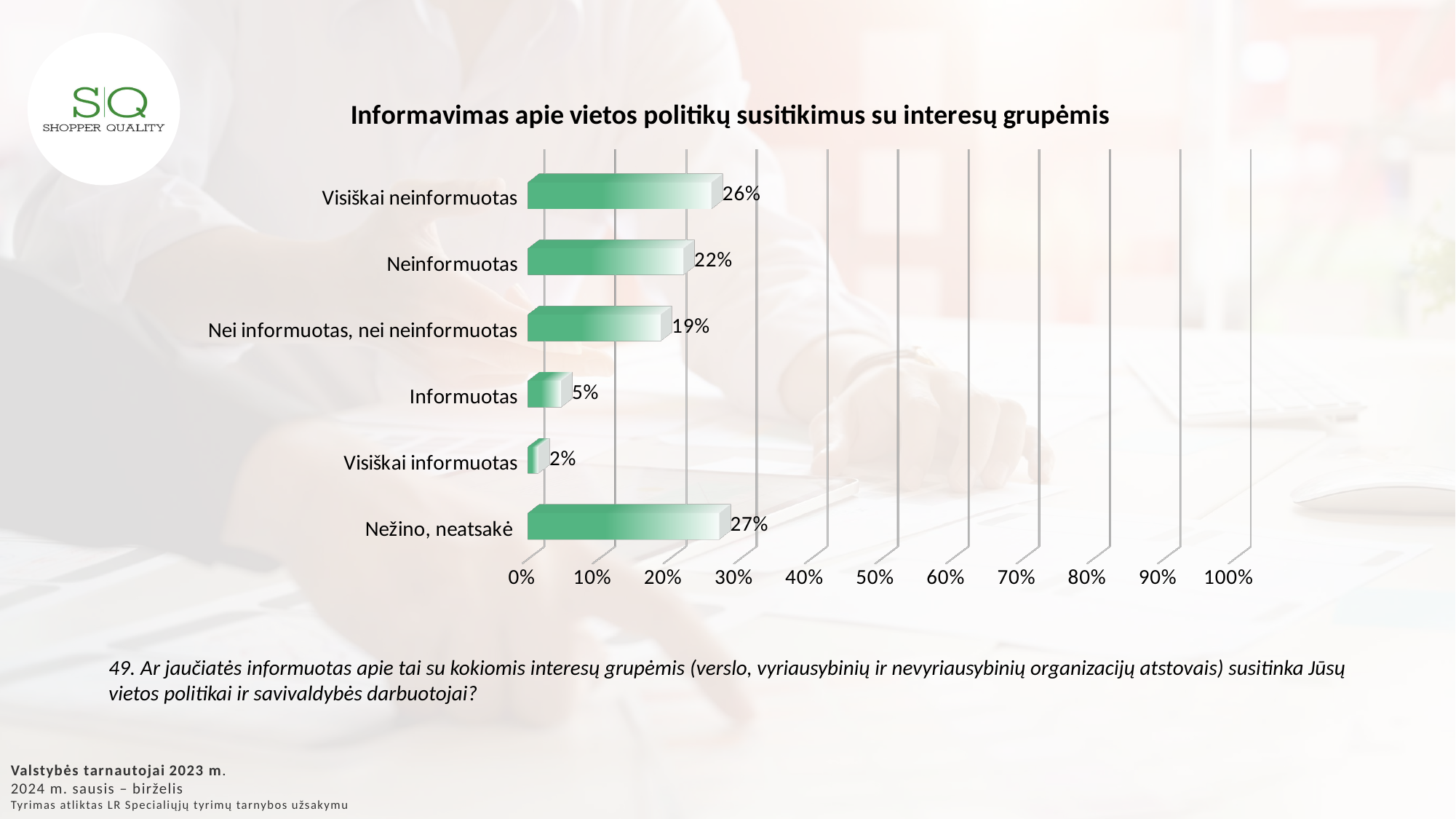
What is the value for "Visiškai informuotas"? 2% Which category has the highest value? Nežino, neatsakė What is the value for "Neinformuotas"? 22% What is the title of the chart? Informavimas apie vietos politikų susitikimus su interesų grupėmis Which is larger, the value for "Informuotas" or the value for "Visiškai informuotas"? Informuotas How many categories are shown in the chart? 6 Is the value for "Nežino, neatsakė" greater or less than 20%? greater What kind of chart is shown on the slide? bar chart What is the value for "Visiškai neinformuotas"? 26% Which category has the lowest value? Visiškai informuotas What is the value for "Nei informuotas, nei neinformuotas"? 19% What is the difference between the values for "Visiškai neinformuotas" and "Neinformuotas"? 4%